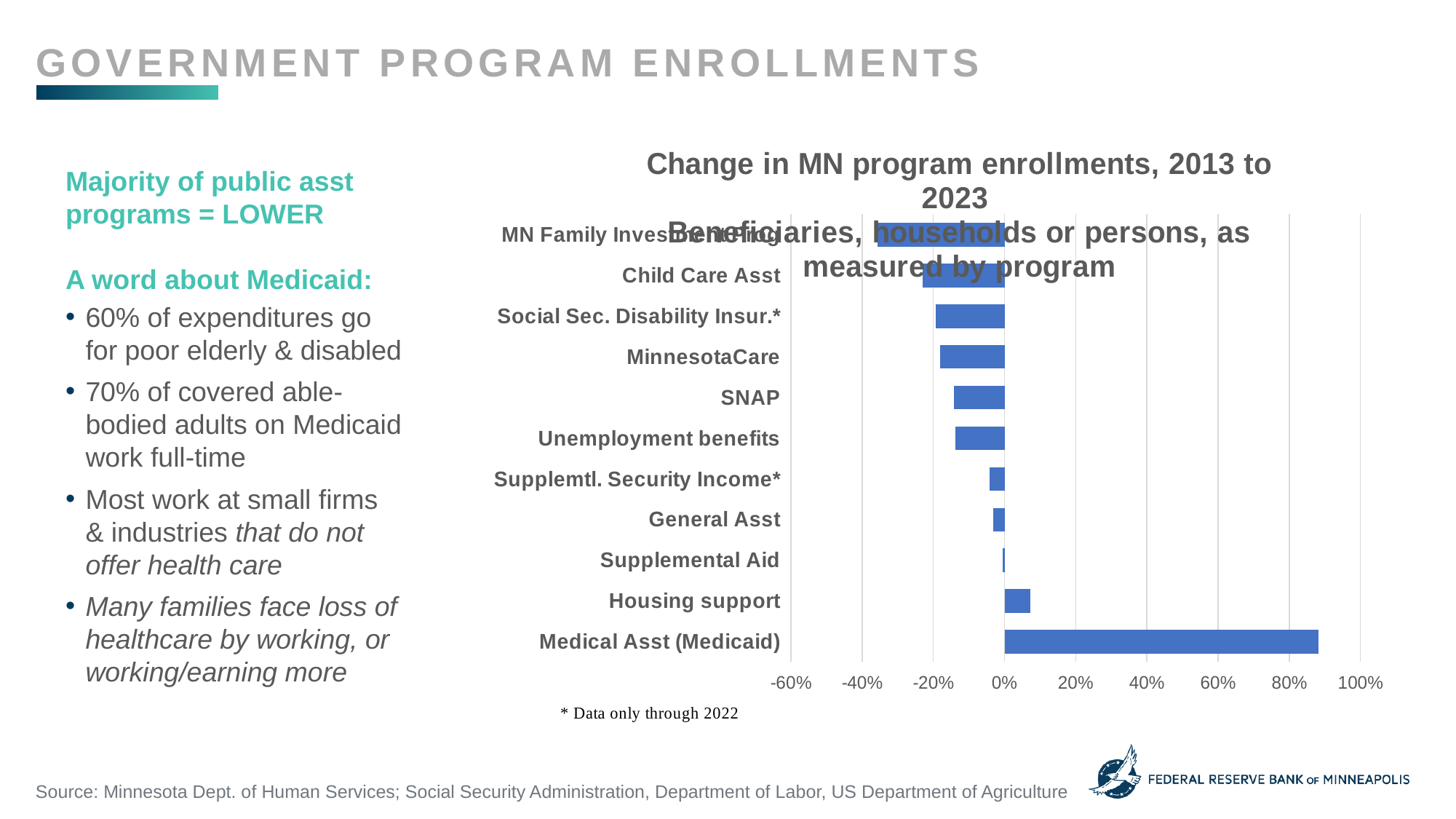
What kind of chart is shown on the slide? Bar chart How many programs show a positive change in enrollments? 2 How many programs (categories) are plotted in the chart? 11 Which is larger, the value for Medical Asst (Medicaid) or the value for Housing support? Medical Asst (Medicaid) What does the asterisk footnote below the chart say? Data only through 2022 Which program shows the largest change in enrollments from 2013 to 2023? Medical Asst (Medicaid) Is the value for Housing support greater or less than 0%? greater Is the value for Medical Asst (Medicaid) greater or less than 80%? greater Which program shows a larger decline in enrollments, Child Care Asst or General Asst? Child Care Asst Is the value for Child Care Asst greater or less than 0%? less What is the title of the chart? Change in MN program enrollments, 2013 to 2023